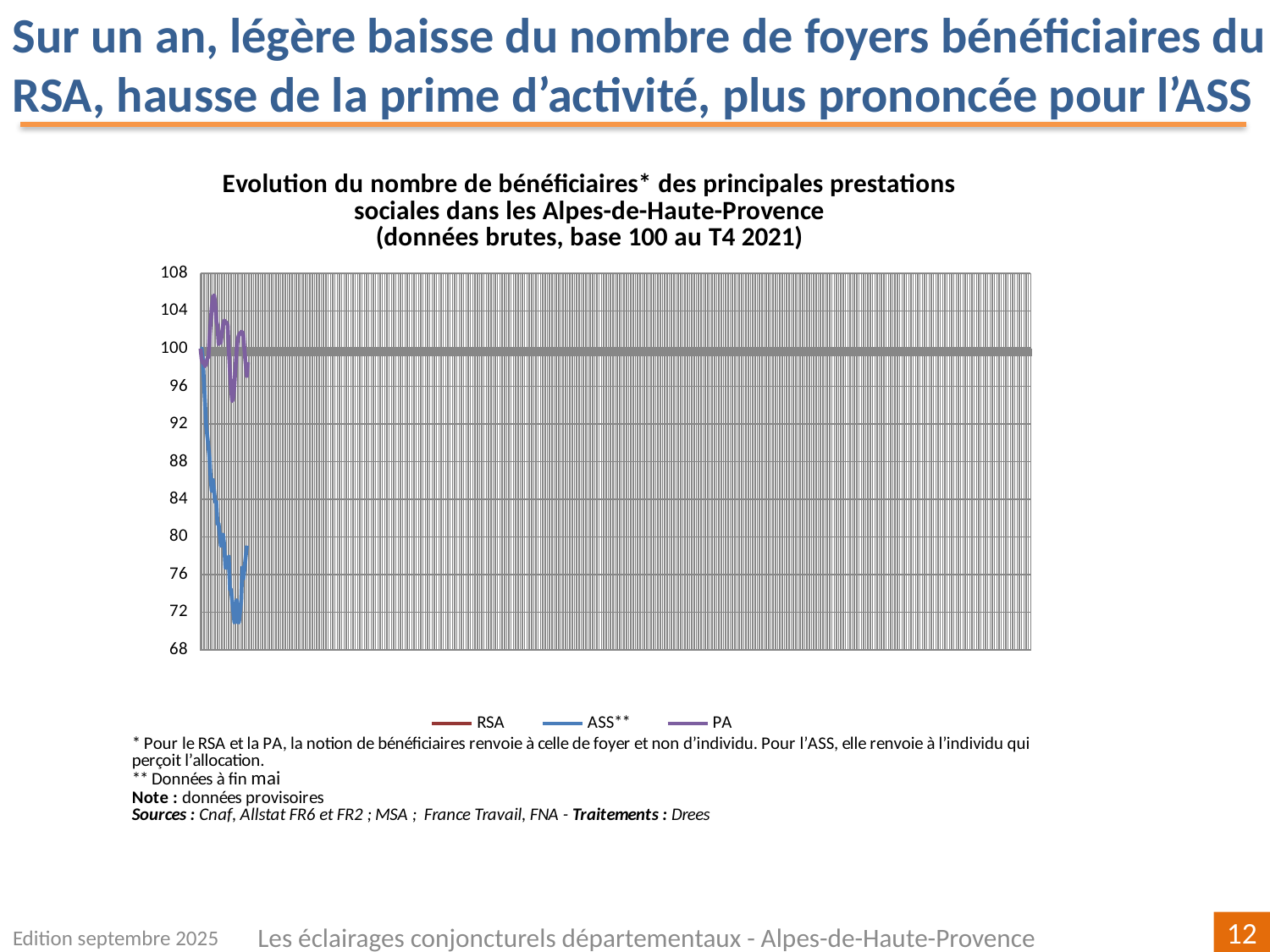
What is the base period used for the index (base 100) according to the chart title? T4 2021 What is the highest value shown on the vertical axis? 108 How many series does the legend list? 3 Does the ASS** series overall rise or fall from its starting value of 100? fall Which series are listed in the chart legend? RSA, ASS**, PA Is the lowest value reached by the ASS** series greater or less than 76? less Which series reaches the highest value on the chart? PA What kind of chart is shown on the slide? line chart Which is lower at its minimum point, the ASS** series or the PA series? ASS** Is the highest value reached by the PA series greater or less than 100? greater Is the lowest value reached by the PA series greater or less than 92? greater Which series reaches the lowest value on the chart? ASS**